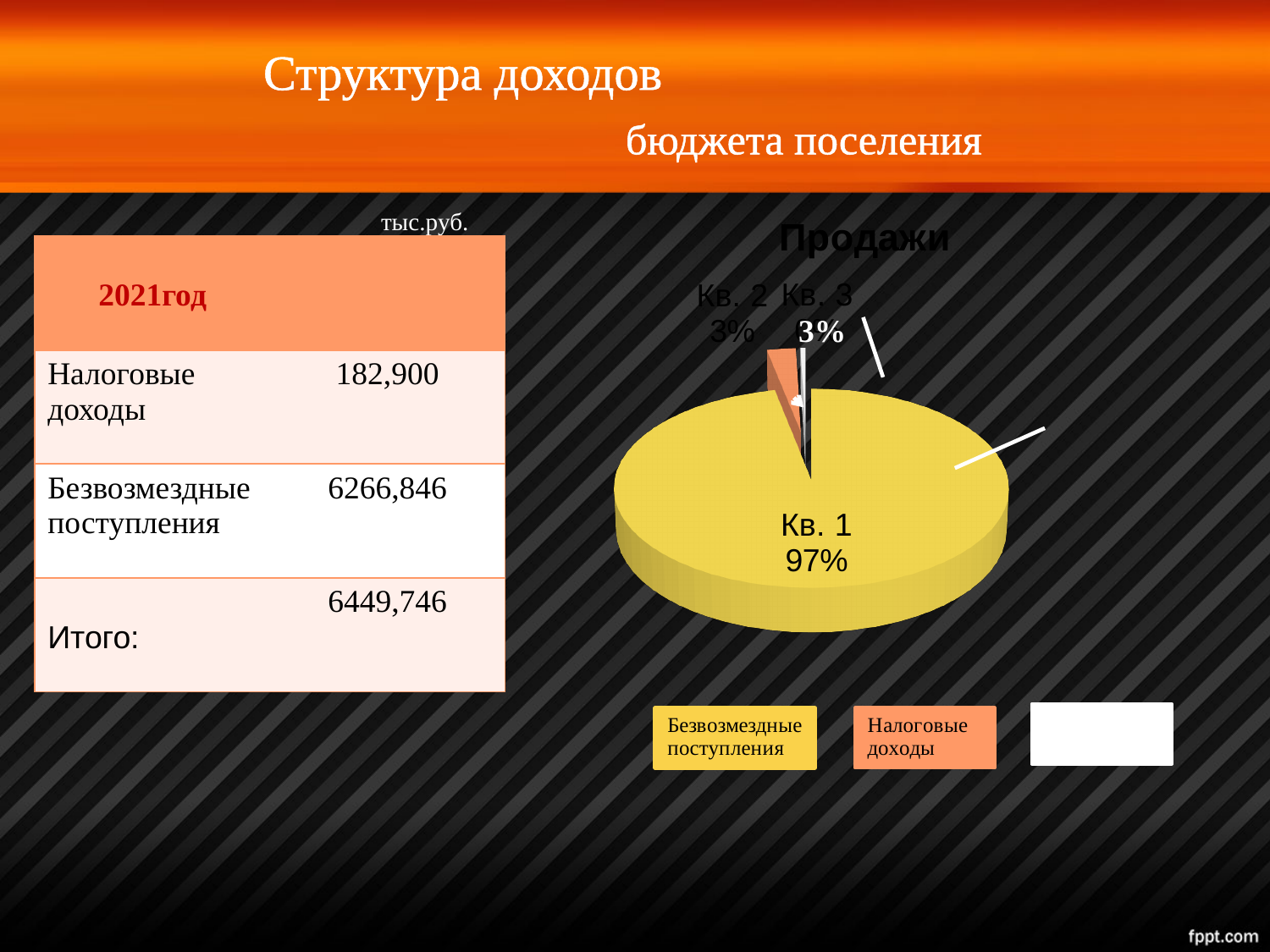
What is the title of the pie chart? Продажи What percentage is shown for Кв. 1 in the pie chart? 97% What kind of chart is shown on the slide? pie chart By how many percentage points does Кв. 1 exceed Кв. 3 in the pie chart? 94 What percentage is shown for Кв. 2 in the pie chart? 3% Which slice of the pie chart is the largest? Кв. 1 What percentage is shown for Кв. 3 in the pie chart? 3% Which is larger in the pie chart, Кв. 1 or Кв. 3? Кв. 1 Is the share for Кв. 1 in the pie chart greater or less than 50%? greater What colour is the largest slice of the pie chart? yellow How many labelled slices does the pie chart have? 3